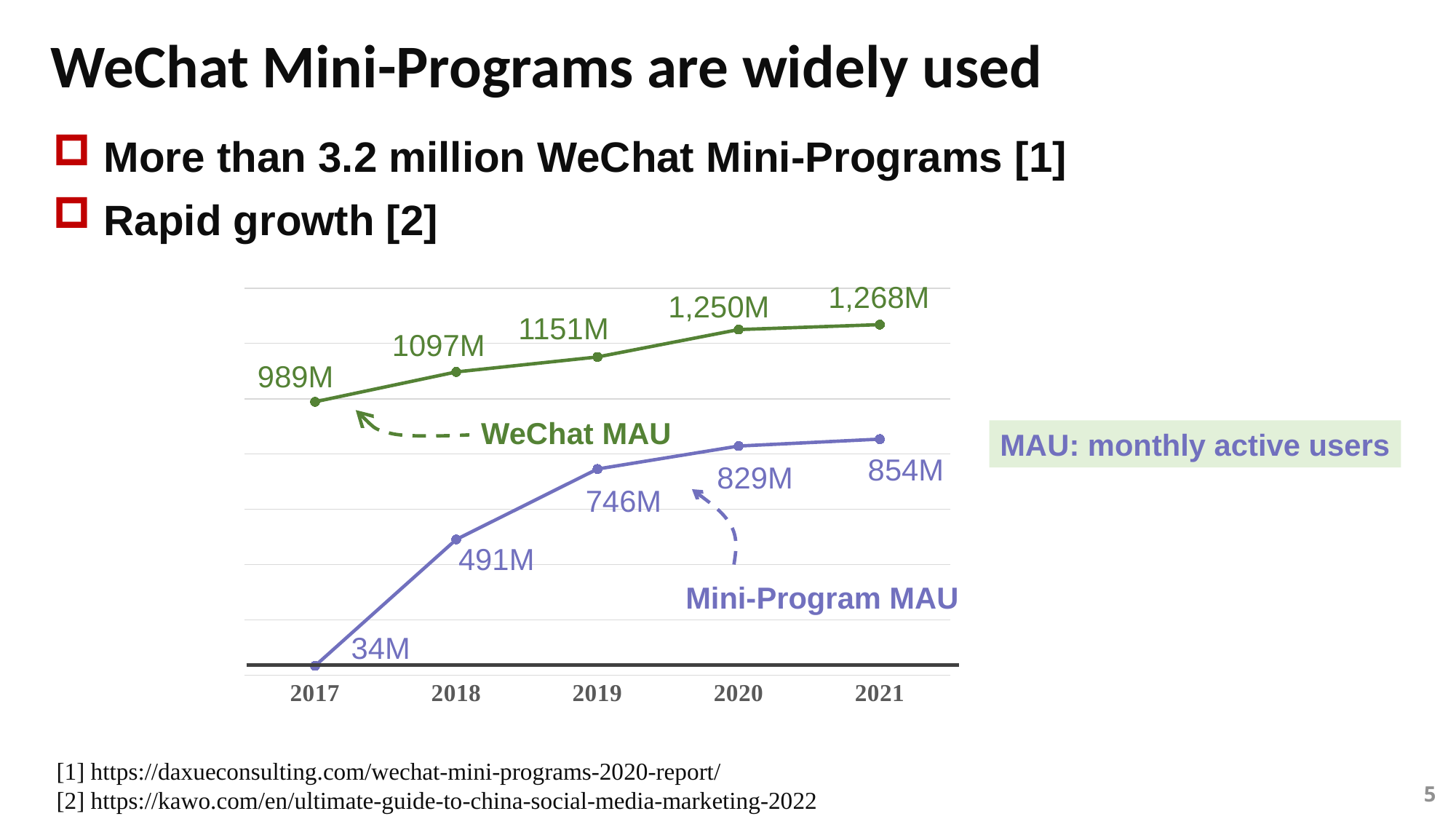
Does the Mini-Program MAU rise or fall from 2017 to 2021? rise Which was larger in 2018, the WeChat MAU or the Mini-Program MAU? WeChat MAU In which year was the Mini-Program MAU highest? 2021 What was the WeChat MAU in 2020? 1,250M In which year was the WeChat MAU lowest? 2017 What kind of chart is shown on the slide? line chart By how much did the Mini-Program MAU increase from 2017 to 2018? 457M What was the WeChat MAU in 2017? 989M What was the Mini-Program MAU in 2017? 34M How many years are plotted on the x axis of the chart? 5 What was the Mini-Program MAU in 2019? 746M What is the difference between the WeChat MAU and the Mini-Program MAU in 2021? 414M